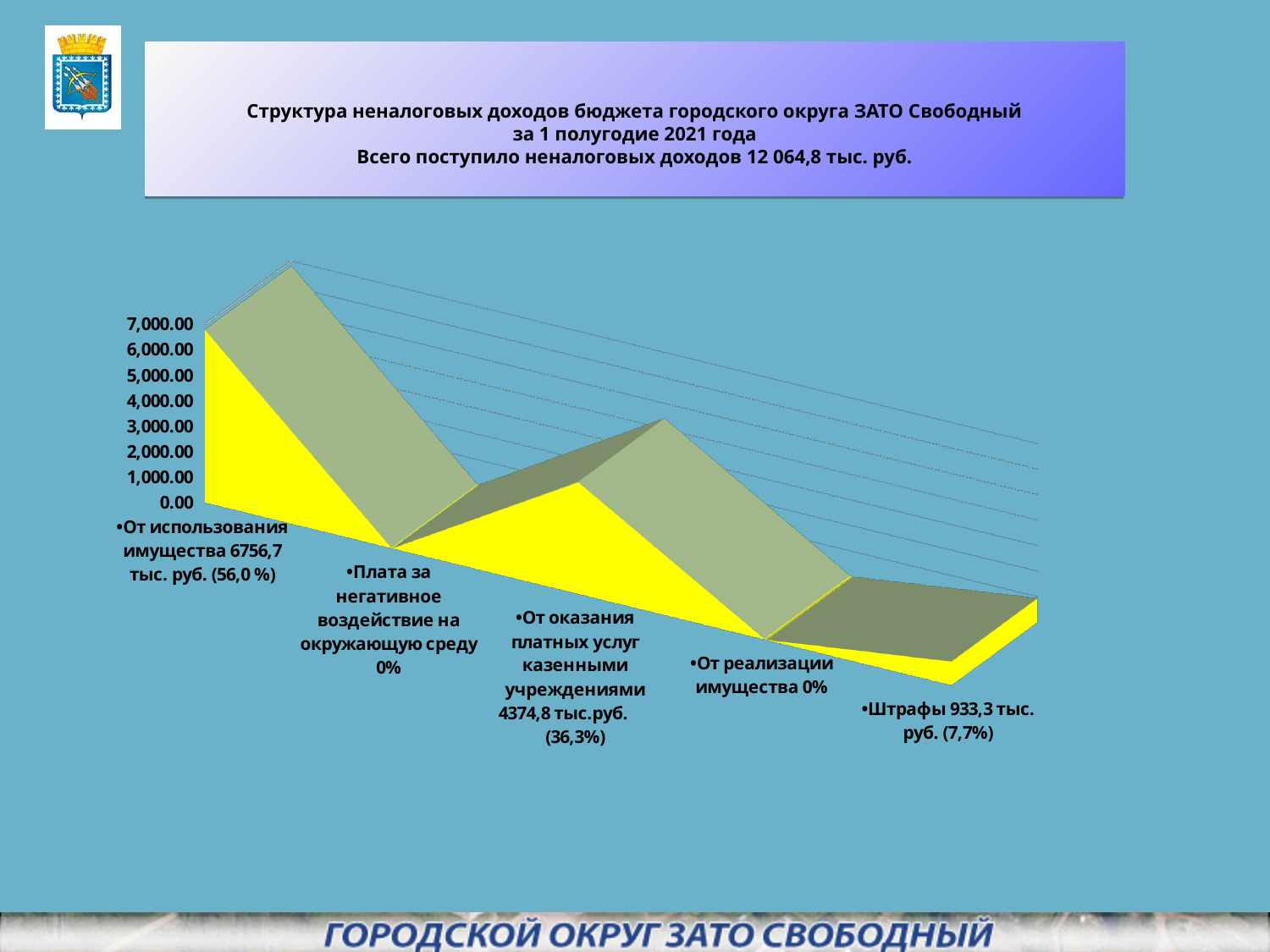
What is the difference between the values for «От использования имущества» and «От оказания платных услуг казенными учреждениями»? 2381,9 тыс. руб. What is the value for «Штрафы»? 933,3 тыс. руб. Which is larger: the value for «От оказания платных услуг казенными учреждениями» or for «Штрафы»? От оказания платных услуг казенными учреждениями Which category has the highest value? От использования имущества Is the value for «От использования имущества» greater or less than 6,000.00? greater What share of non-tax revenues does «От оказания платных услуг казенными учреждениями» account for? 36,3% How many categories are plotted on the chart? 5 What is the value for «От использования имущества»? 6756,7 тыс. руб. What is the value for «От оказания платных услуг казенными учреждениями»? 4374,8 тыс. руб. What kind of chart is shown on the slide? area chart What total amount of non-tax revenues is stated in the chart title? 12 064,8 тыс. руб. What share of non-tax revenues does «Штрафы» account for? 7,7%